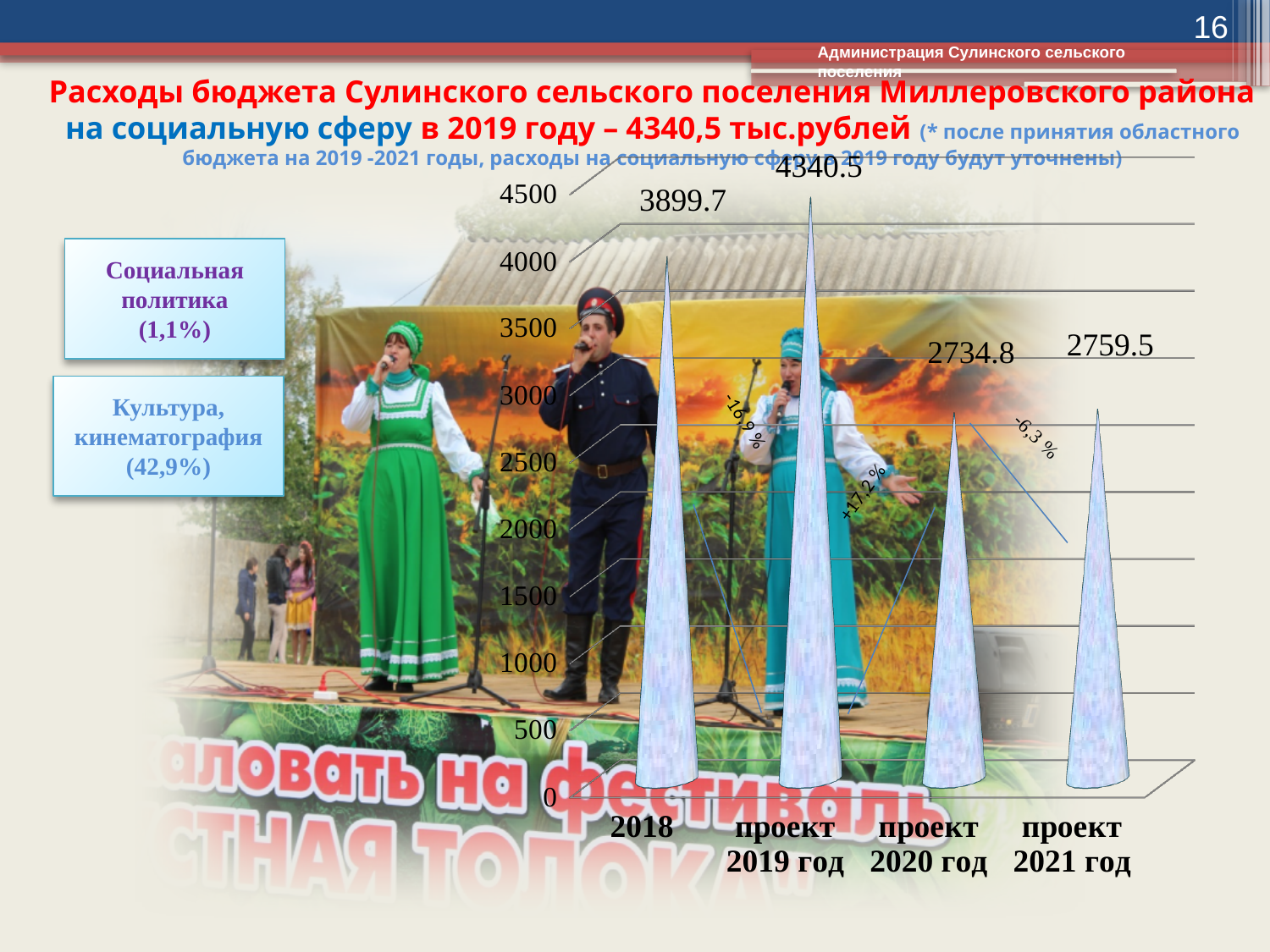
Which category has the highest value? проект 2019 год What is the value for проект 2019 год? 4340.5 Which category has the lowest value? проект 2020 год How many categories are shown on the x axis? 4 Is the value for проект 2020 год greater or less than 3000? less What is the value for проект 2020 год? 2734.8 What is the value for 2018? 3899.7 Which is larger, the value for 2018 or the value for проект 2021 год? 2018 What is the difference between the values for проект 2019 год and 2018? 440.8 What is the value for проект 2021 год? 2759.5 What is the difference between the values for 2018 and проект 2020 год? 1164.9 What is the highest tick value shown on the vertical axis? 4500